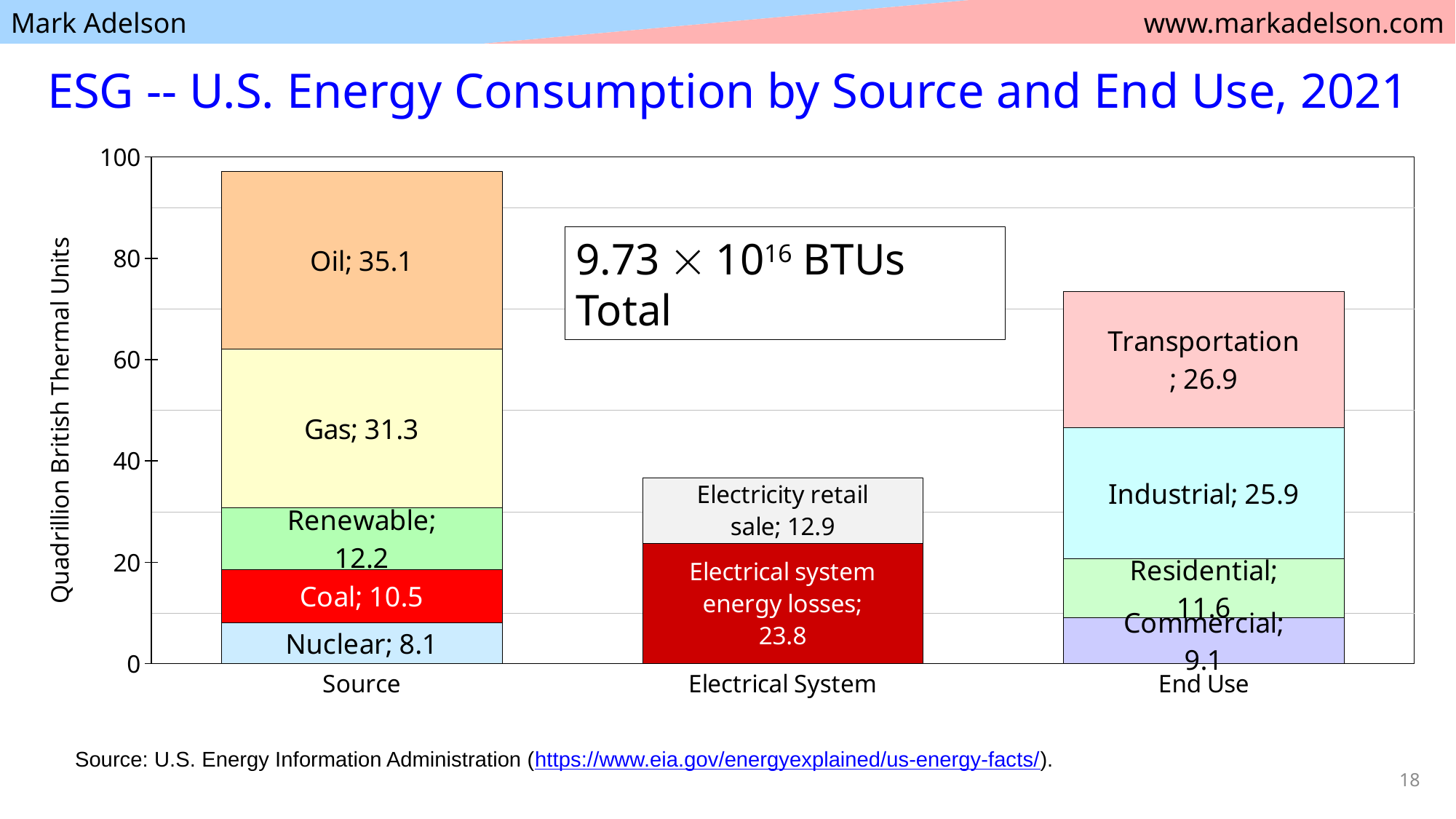
What is the total of the Electrical System bar? 36.7 How many bars (categories) are shown on the x axis? 3 What is the label of the y axis? Quadrillion British Thermal Units Which segment of the Source bar has the smallest value? Nuclear Which is larger in the Electrical System bar: Electricity retail sale or Electrical system energy losses? Electrical system energy losses What is the value for Industrial in the End Use bar? 25.9 What type of chart is shown on the slide? Stacked bar chart What is the value for Electrical system energy losses in the Electrical System bar? 23.8 Which segment of the End Use bar has the largest value? Transportation What is the value for Oil in the Source bar? 35.1 What is the difference between the Oil and Gas values in the Source bar? 3.8 What is the total of the End Use bar? 73.5